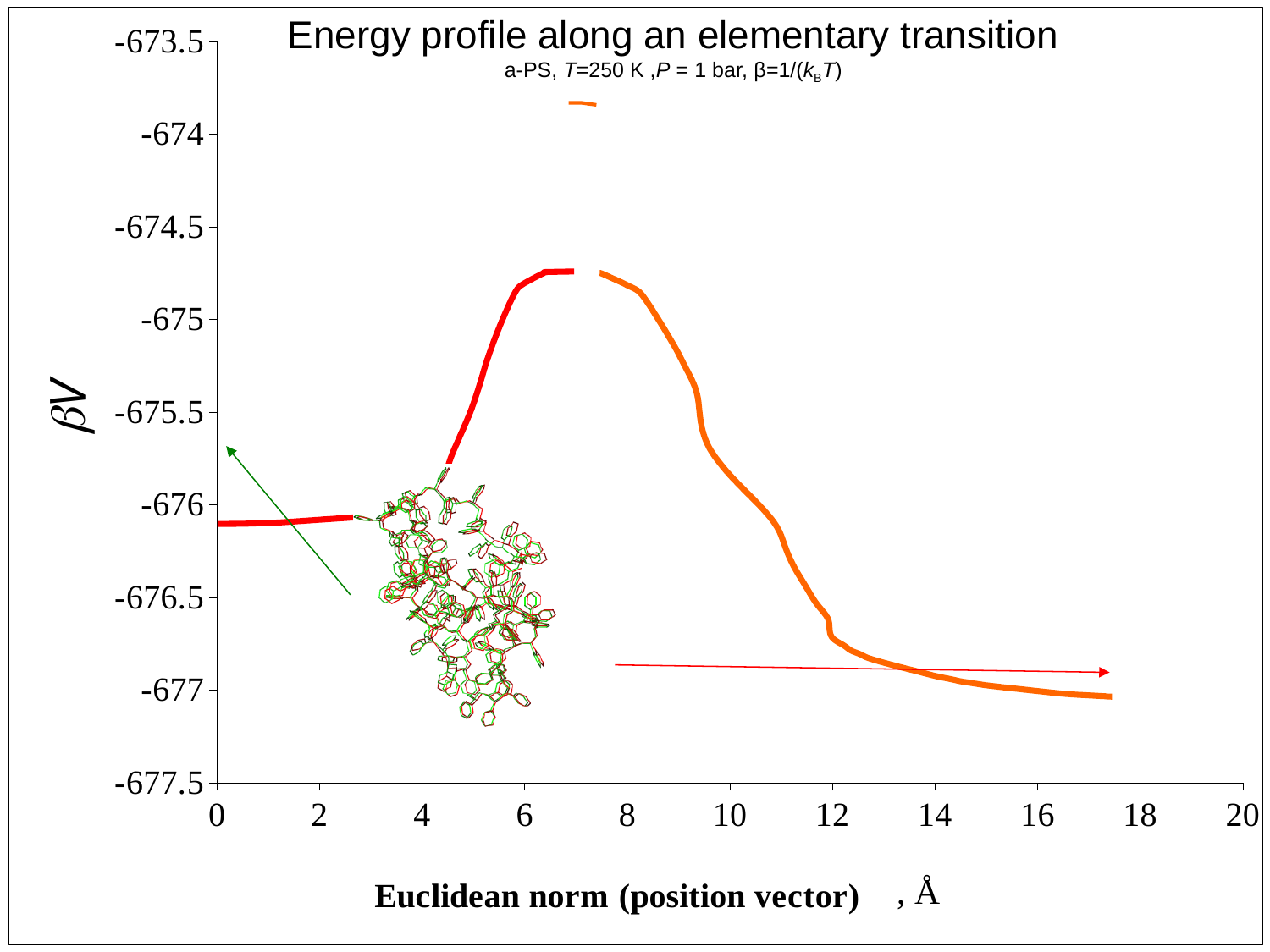
What kind of chart is shown on the slide? line chart Which is larger, the value of the curve at x = 6 or at x = 16? x = 6 Do the values rise or fall as x increases from 0 to 6? rise What is the label of the x axis? Euclidean norm (position vector), Å Do the values rise or fall as x increases from 8 to 18? fall What is the title of the chart? Energy profile along an elementary transition Is the value of the curve at x = 8 greater or less than -675? greater Which is larger, the value of the curve at x = 0 or at x = 8? x = 8 Is the value of the curve at x = 12 greater or less than -676.5? less Is the value of the curve at x = 0 greater or less than -676? less